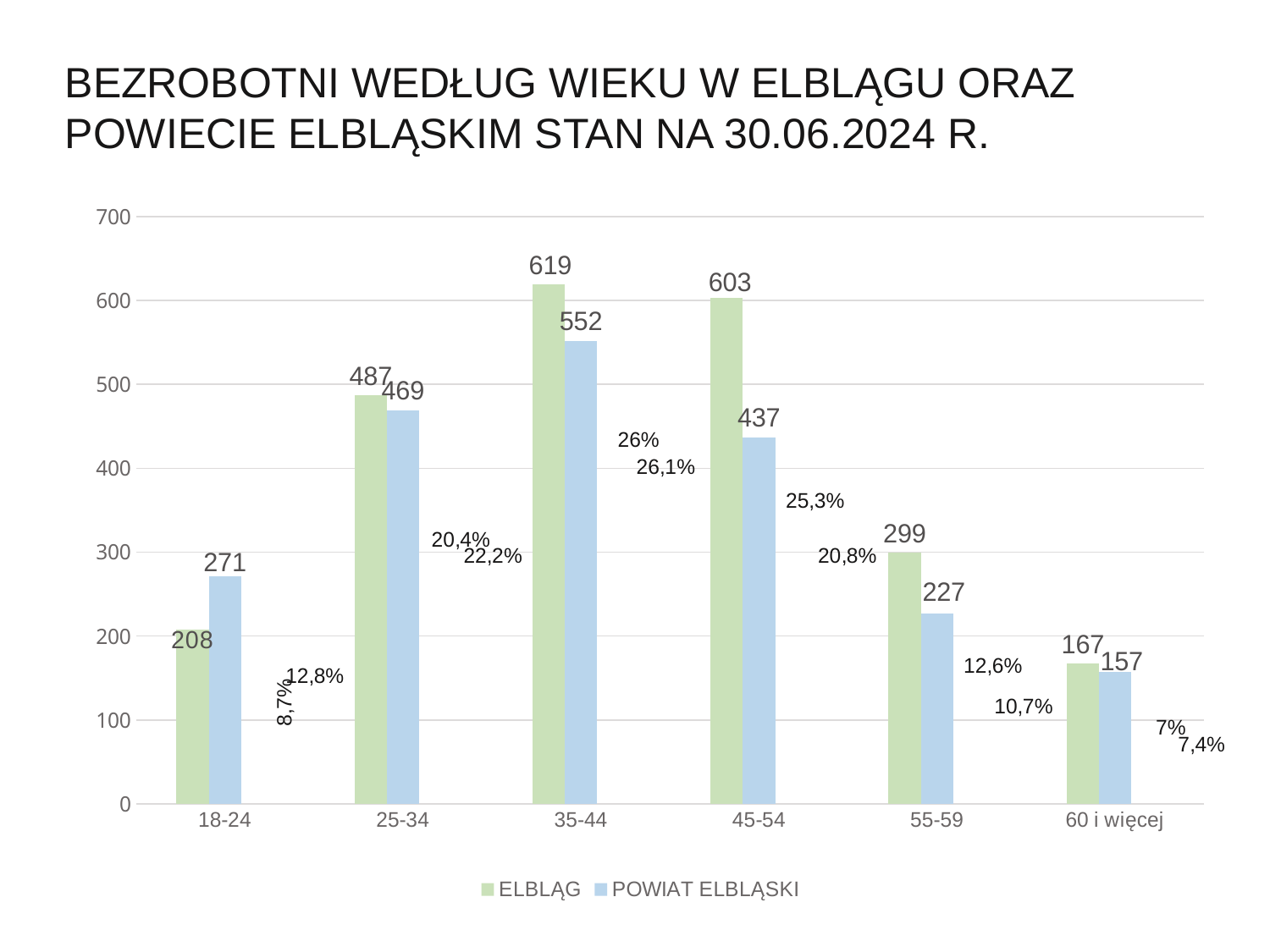
What is the difference between the ELBLĄG and POWIAT ELBLĄSKI values in the 45-54 age group? 166 Which age group has the lowest value for POWIAT ELBLĄSKI? 60 i więcej Is the value for ELBLĄG in the 55-59 age group greater or less than 200? greater What kind of chart is shown on the slide? bar chart What is the value for ELBLĄG in the 35-44 age group? 619 How many age groups are shown on the x axis? 6 What is the value for POWIAT ELBLĄSKI in the 18-24 age group? 271 Which is larger in the 18-24 age group, the value for ELBLĄG or for POWIAT ELBLĄSKI? POWIAT ELBLĄSKI How many series does the legend list? 2 Which series is shown in green in the legend? ELBLĄG What is the value for POWIAT ELBLĄSKI in the 45-54 age group? 437 Which age group has the highest value for ELBLĄG? 35-44